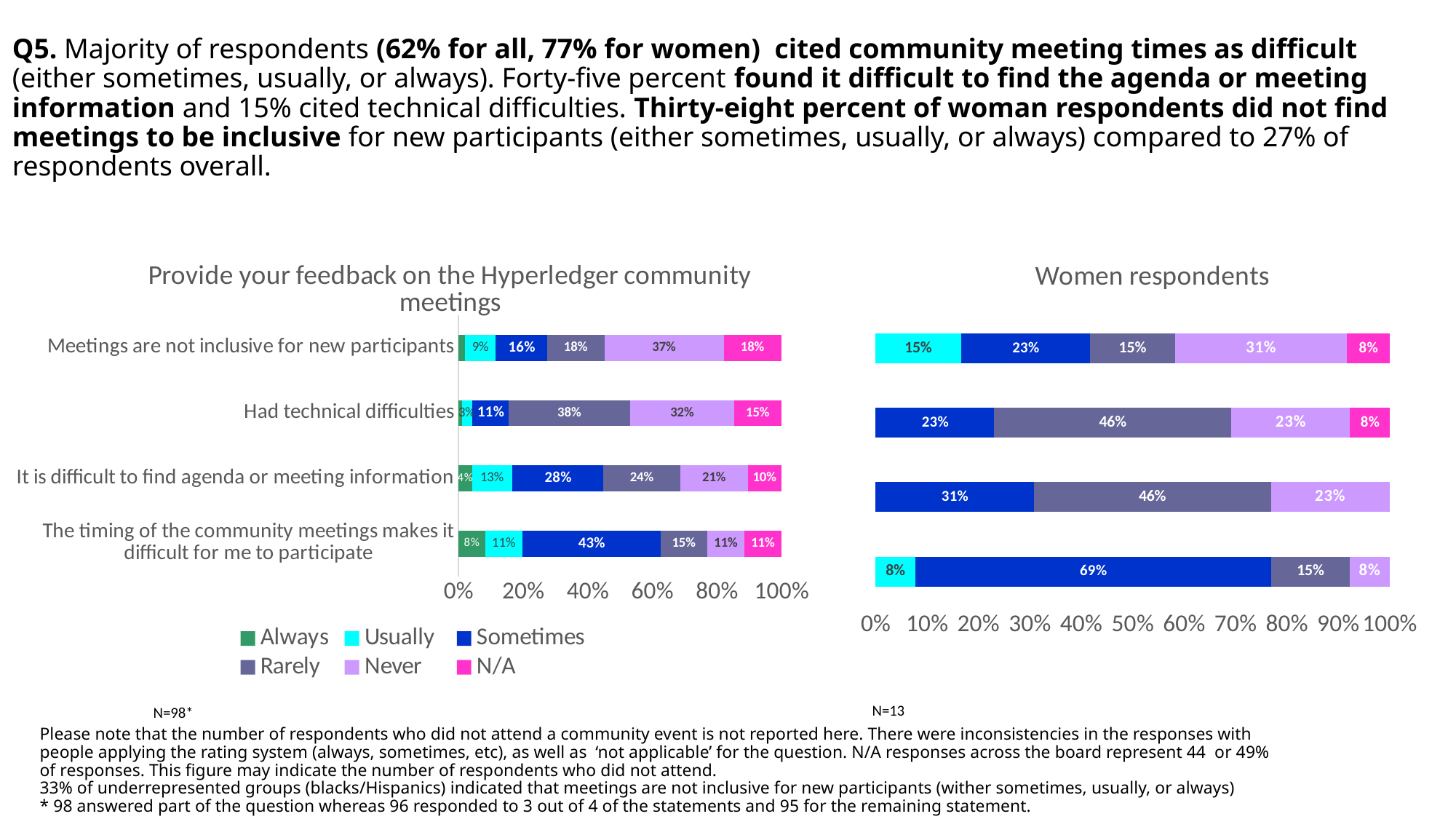
In the "Women respondents" chart, what is the value of the "Never" (light purple) segment in the top bar? 31% Which legend entry is shown in dark blue in the chart titled "Provide your feedback on the Hyperledger community meetings"? Sometimes In the chart titled "Provide your feedback on the Hyperledger community meetings", what percentage of respondents answered "Never" for "Meetings are not inclusive for new participants"? 37% In the chart titled "Provide your feedback on the Hyperledger community meetings", what percentage answered "Rarely" for "Had technical difficulties"? 38% In the chart titled "Provide your feedback on the Hyperledger community meetings", is the "Rarely" value for "Had technical difficulties" larger or the "Rarely" value for "It is difficult to find agenda or meeting information"? Had technical difficulties In the chart titled "Provide your feedback on the Hyperledger community meetings", what is the difference between the "Never" percentages for "Meetings are not inclusive for new participants" and "It is difficult to find agenda or meeting information"? 16% In the "Women respondents" chart, what is the largest segment value in the bottom bar? 69% In the chart titled "Provide your feedback on the Hyperledger community meetings", what percentage answered "Sometimes" for "The timing of the community meetings makes it difficult for me to participate"? 43% What kind of chart is the "Women respondents" chart? Stacked bar chart In the chart titled "Provide your feedback on the Hyperledger community meetings", which statement has the highest "Sometimes" percentage? The timing of the community meetings makes it difficult for me to participate How many statements (categories) are shown in the chart titled "Provide your feedback on the Hyperledger community meetings"? 4 How many series does the legend of the chart titled "Provide your feedback on the Hyperledger community meetings" list? 6